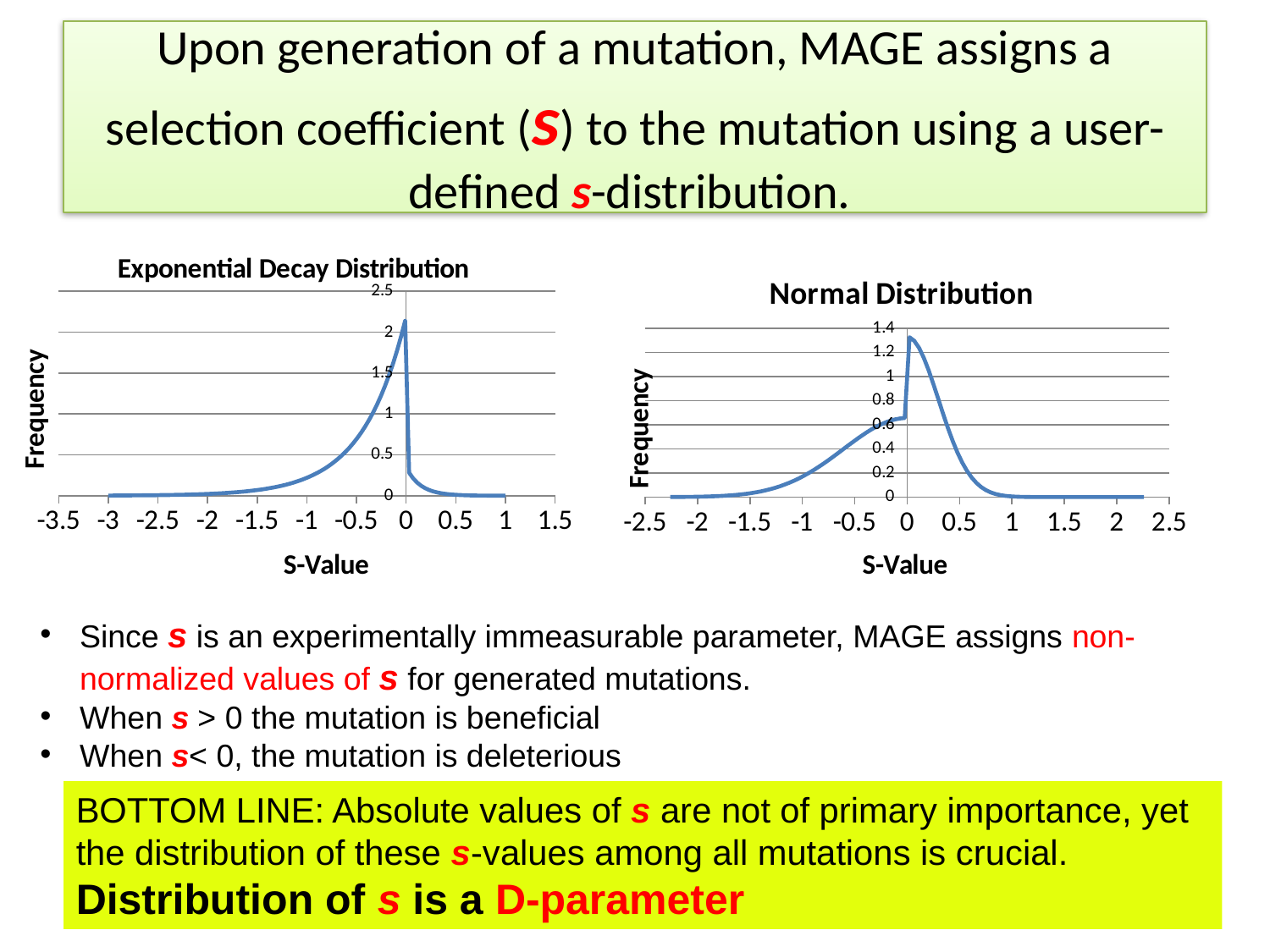
What kind of chart is the Exponential Decay Distribution chart? line chart What is the title of the chart on the left of the slide? Exponential Decay Distribution In the Normal Distribution chart, does the curve rise or fall as S-Value increases from 0 to 1? fall How many charts are shown on the slide? 2 In the Normal Distribution chart, is the peak value of the curve greater or less than 1.2? greater In the Exponential Decay Distribution chart, is the peak value of the curve greater or less than 2? greater What kind of chart is the Normal Distribution chart? line chart In the Normal Distribution chart, is the value at S-Value -1 greater or less than 0.4? less What is the highest tick value on the y-axis of the Normal Distribution chart? 1.4 What is the x-axis label of the Normal Distribution chart? S-Value In the Exponential Decay Distribution chart, does the curve rise or fall as S-Value increases from -3 to 0? rise